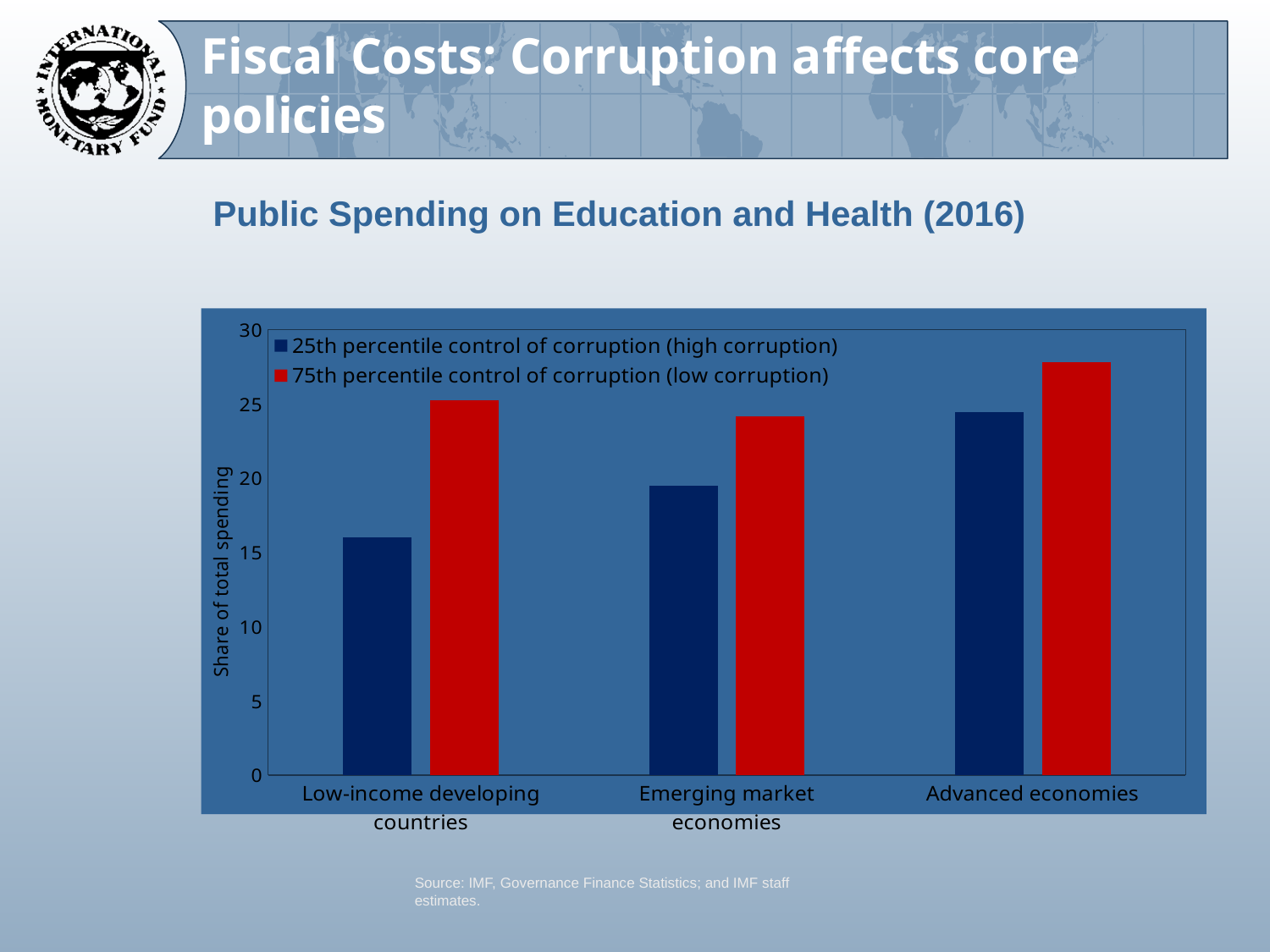
What kind of chart is shown on the slide? bar chart How many country groups are shown on the x axis? 3 How many series does the legend list? 2 Do the values for the 25th percentile control of corruption (high corruption) series rise or fall from Low-income developing countries to Advanced economies? rise Is the value for Advanced economies in the 75th percentile control of corruption (low corruption) series greater or less than 25? greater What is the title of the chart? Public Spending on Education and Health (2016) Is the value for Low-income developing countries in the 25th percentile control of corruption (high corruption) series greater or less than 20? less What is the label on the y axis? Share of total spending Is the value for Emerging market economies in the 75th percentile control of corruption (low corruption) series greater or less than 20? greater Which country group has the lowest value for the 25th percentile control of corruption (high corruption) series? Low-income developing countries For Low-income developing countries, which series has the larger value: 25th percentile control of corruption (high corruption) or 75th percentile control of corruption (low corruption)? 75th percentile control of corruption (low corruption) Which country group has the highest value for the 75th percentile control of corruption (low corruption) series? Advanced economies